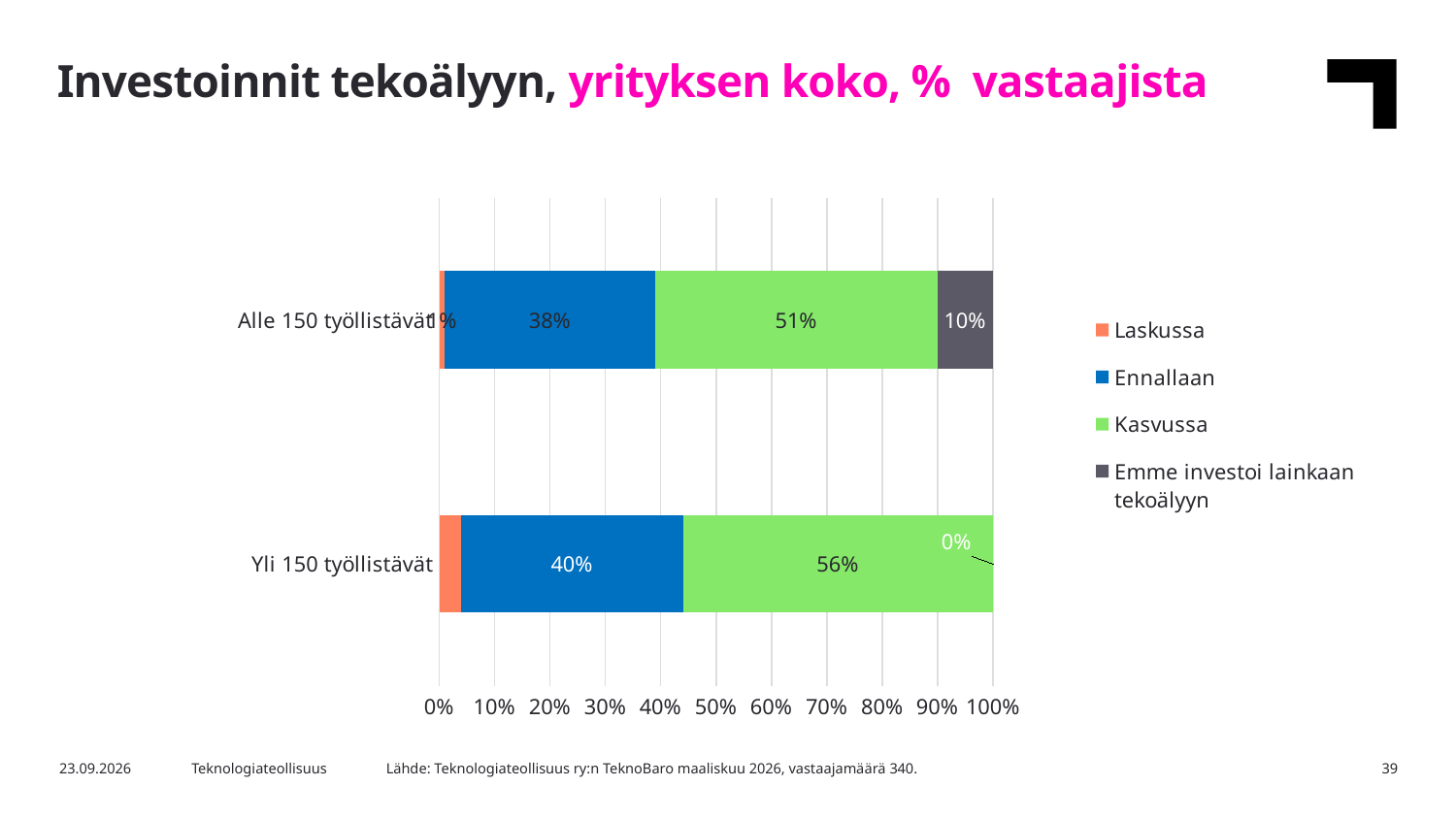
What is the value of Emme investoi lainkaan tekoälyyn for Yli 150 työllistävät? 0% What is the value of Kasvussa for Yli 150 työllistävät? 56% What is the difference in the Kasvussa share between Yli 150 työllistävät and Alle 150 työllistävät? 5 percentage points What is the value of Kasvussa for Alle 150 työllistävät? 51% What kind of chart is shown on the slide? Stacked bar chart Which series has the largest share for Alle 150 työllistävät? Kasvussa How many categories are shown on the chart? 2 What is the value of Emme investoi lainkaan tekoälyyn for Alle 150 työllistävät? 10% What is the value of Ennallaan for Yli 150 työllistävät? 40% How many series does the legend list? 4 What is the difference in the Ennallaan share between Yli 150 työllistävät and Alle 150 työllistävät? 2 percentage points Which category has the larger Kasvussa share, Alle 150 työllistävät or Yli 150 työllistävät? Yli 150 työllistävät